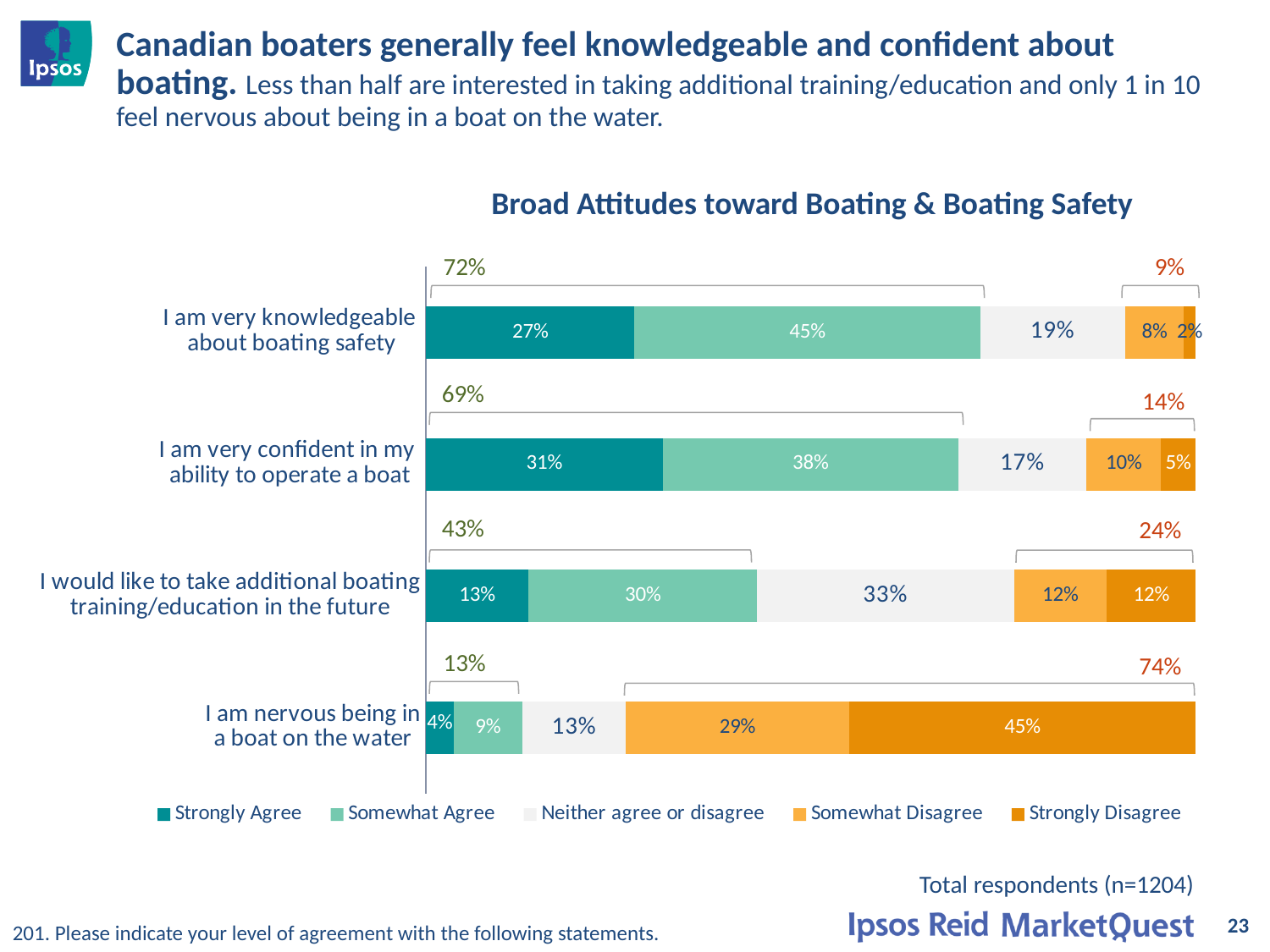
What percentage strongly disagree that they are nervous being in a boat on the water? 45% How many statements are shown in the chart? 4 What percentage of respondents strongly agree that they are very knowledgeable about boating safety? 27% What percentage neither agree nor disagree with wanting to take additional boating training/education in the future? 33% Which is larger: the Strongly Agree percentage for 'I am very confident in my ability to operate a boat' or for 'I am very knowledgeable about boating safety'? I am very confident in my ability to operate a boat Which statement has the highest Strongly Disagree percentage? I am nervous being in a boat on the water What percentage somewhat agree that they are very confident in their ability to operate a boat? 38% What is the title of the chart? Broad Attitudes toward Boating & Boating Safety How many series does the legend list? 5 What kind of chart is shown on the slide? Stacked bar chart What is the difference between the Somewhat Agree percentages for 'I am very knowledgeable about boating safety' and 'I am very confident in my ability to operate a boat'? 7% Which statement has the lowest Strongly Agree percentage? I am nervous being in a boat on the water